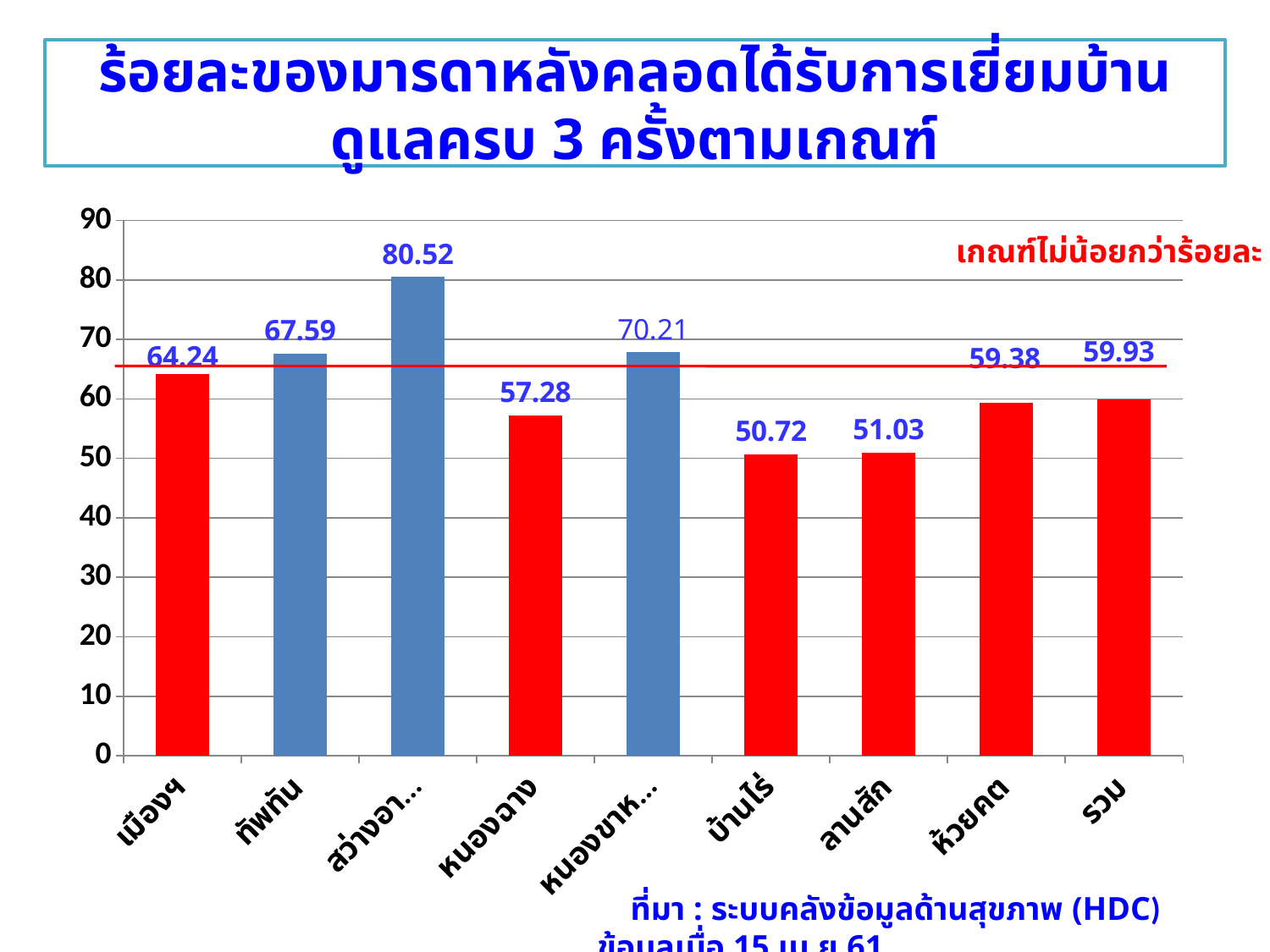
How many categories are shown on the x axis? 9 Which category has the lowest value? บ้านไร่ What is the value for ทัพทัน? 67.59 What kind of chart is shown on the slide? Bar chart What is the value for รวม? 59.93 What is the difference between the values for ทัพทัน and หนองฉาง? 10.31 What is the value for เมืองฯ? 64.24 How many bars are coloured blue? 3 What is the value for หนองฉาง? 57.28 What is the value for บ้านไร่? 50.72 Which is larger, the value for ลานสัก or the value for ห้วยคต? ห้วยคต Which category has the highest value? สว่างอา...